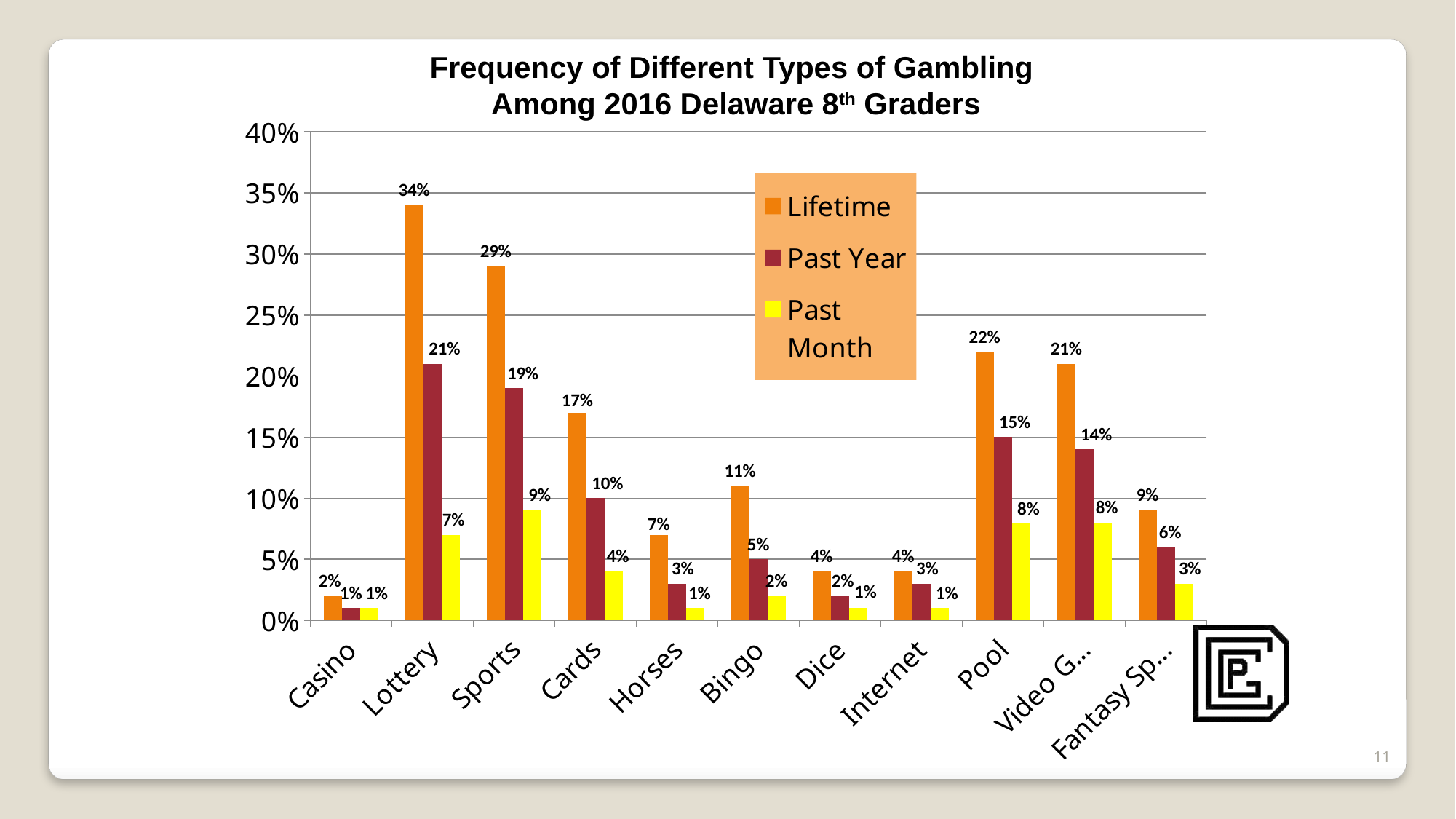
How many series does the legend list? 3 What kind of chart is shown on the slide? Bar chart What is the Past Year value for Sports? 19% Which category has the highest Lifetime value? Lottery What is the Lifetime value for Lottery? 34% What is the Lifetime value for Bingo? 11% What is the difference between the Lifetime and Past Year values for Cards? 7% How many categories are shown on the x axis? 11 Which category has the lowest Lifetime value? Casino Which is larger, the Lifetime value for Pool or the Lifetime value for Sports? Sports What is the Past Month value for Pool? 8% Which series is shown in yellow in the legend? Past Month